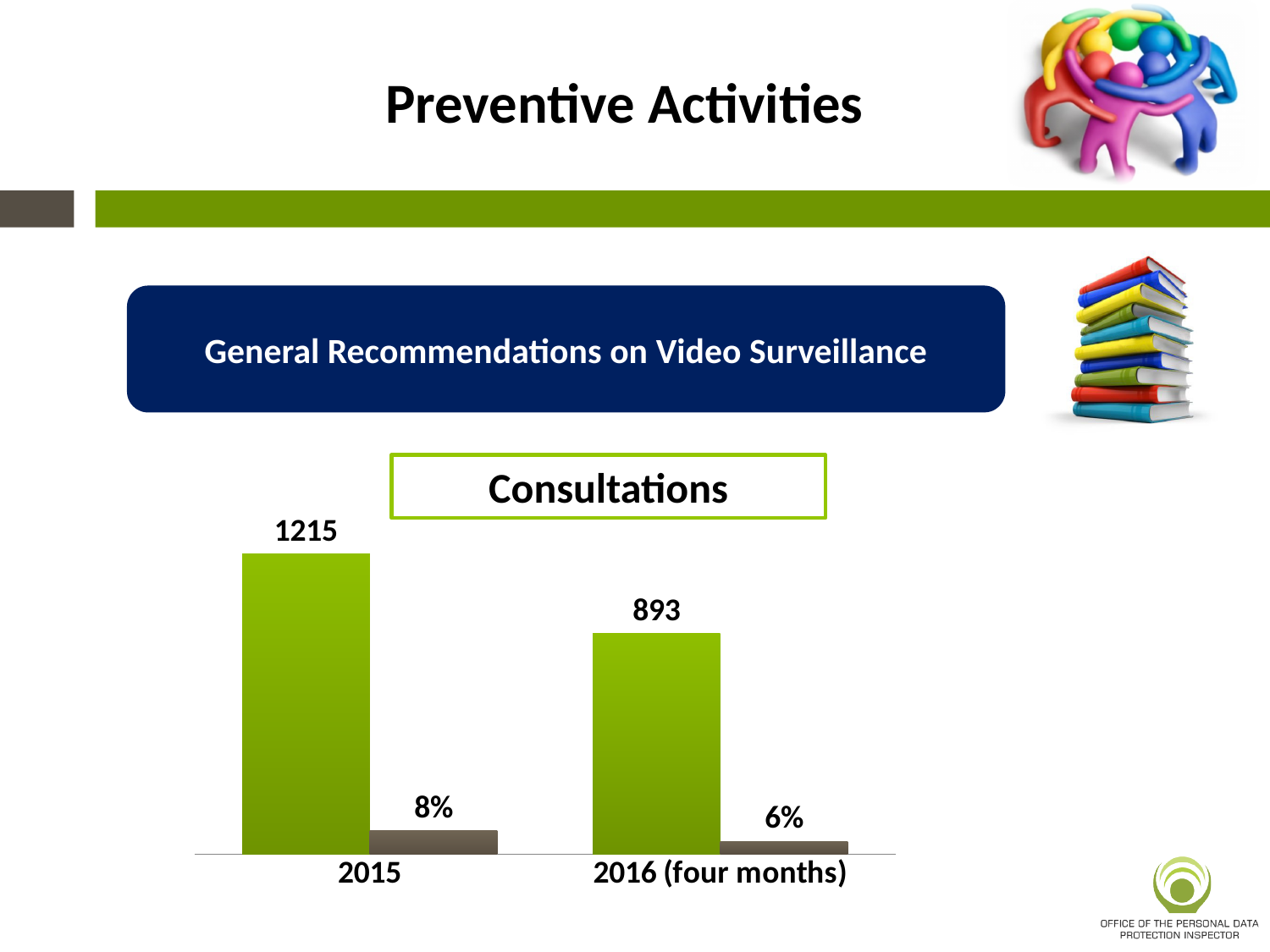
Which category has the higher green bar in the Consultations chart? 2015 Do the green bar values rise or fall from 2015 to 2016 (four months) in the Consultations chart? fall What is the value of the green bar for 2015 in the Consultations chart? 1215 What type of chart is the Consultations chart? bar chart In the Consultations chart, is the green bar value for 2015 larger or smaller than that for 2016 (four months)? larger What is the difference between the green bar values for 2015 and 2016 (four months) in the Consultations chart? 322 What percentage is shown by the brown bar for 2015 in the Consultations chart? 8% What is the value of the green bar for 2016 (four months) in the Consultations chart? 893 How many categories are shown on the x axis of the Consultations chart? 2 What is the difference between the percentage values for 2015 and 2016 (four months) in the Consultations chart? 2% Which category has the lower percentage value in the Consultations chart? 2016 (four months) What percentage is shown by the brown bar for 2016 (four months) in the Consultations chart? 6%